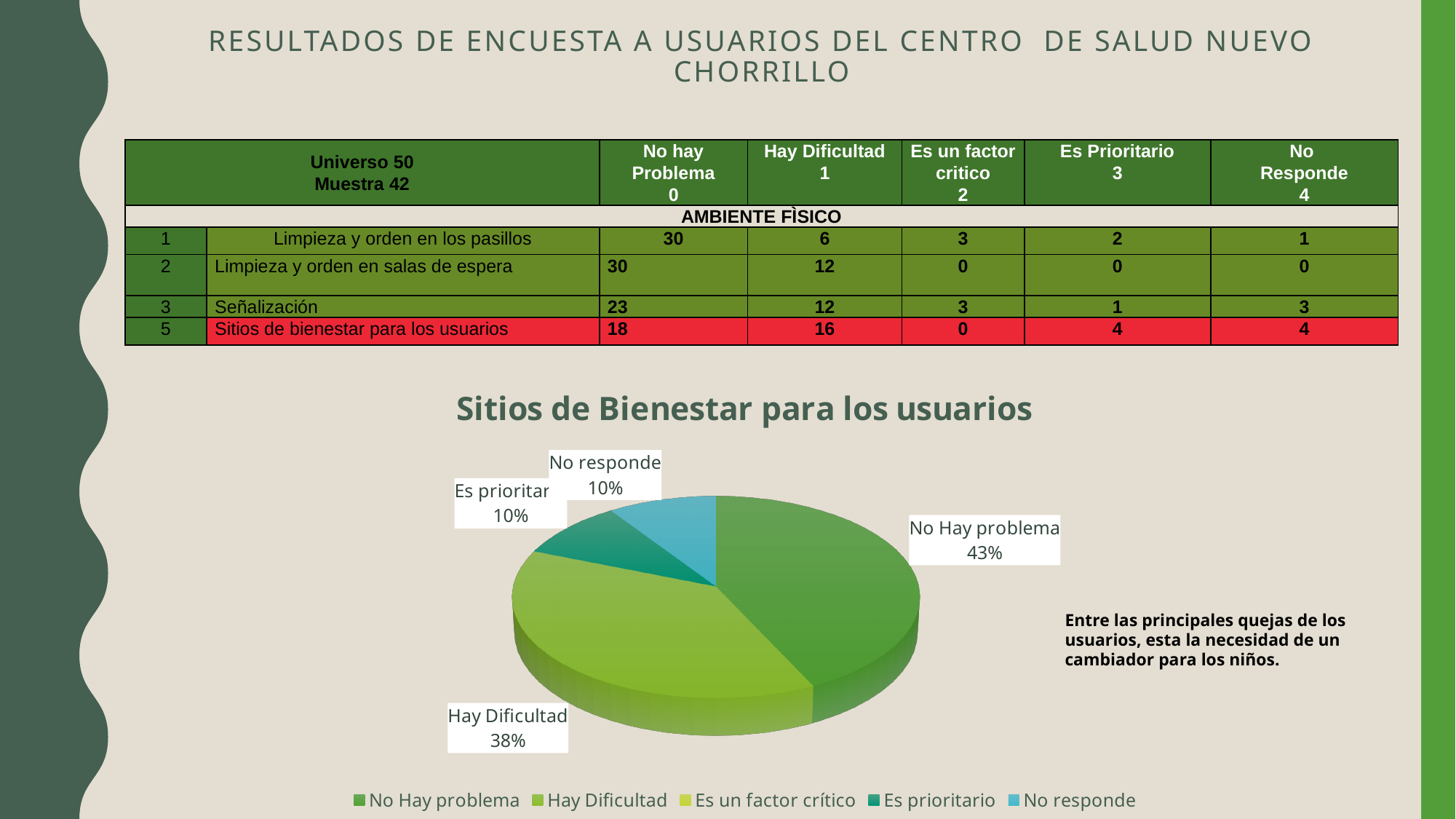
What share of the pie does 'Hay Dificultad' represent? 38% What is the title of the chart? Sitios de Bienestar para los usuarios What kind of chart is shown on the slide? pie chart How many slices with data labels are visible in the pie? 4 Which legend entry has no visible slice in the pie? Es un factor crítico Which is larger, the slice for 'No Hay problema' or the slice for 'Hay Dificultad'? No Hay problema What is the difference in percentage points between 'No Hay problema' and 'Hay Dificultad'? 5 Which category has the largest slice of the pie? No Hay problema What share of the pie does 'No Hay problema' represent? 43% What percentage is shown for 'No responde'? 10% How many entries does the chart legend list? 5 What percentage is shown for 'Es prioritario'? 10%